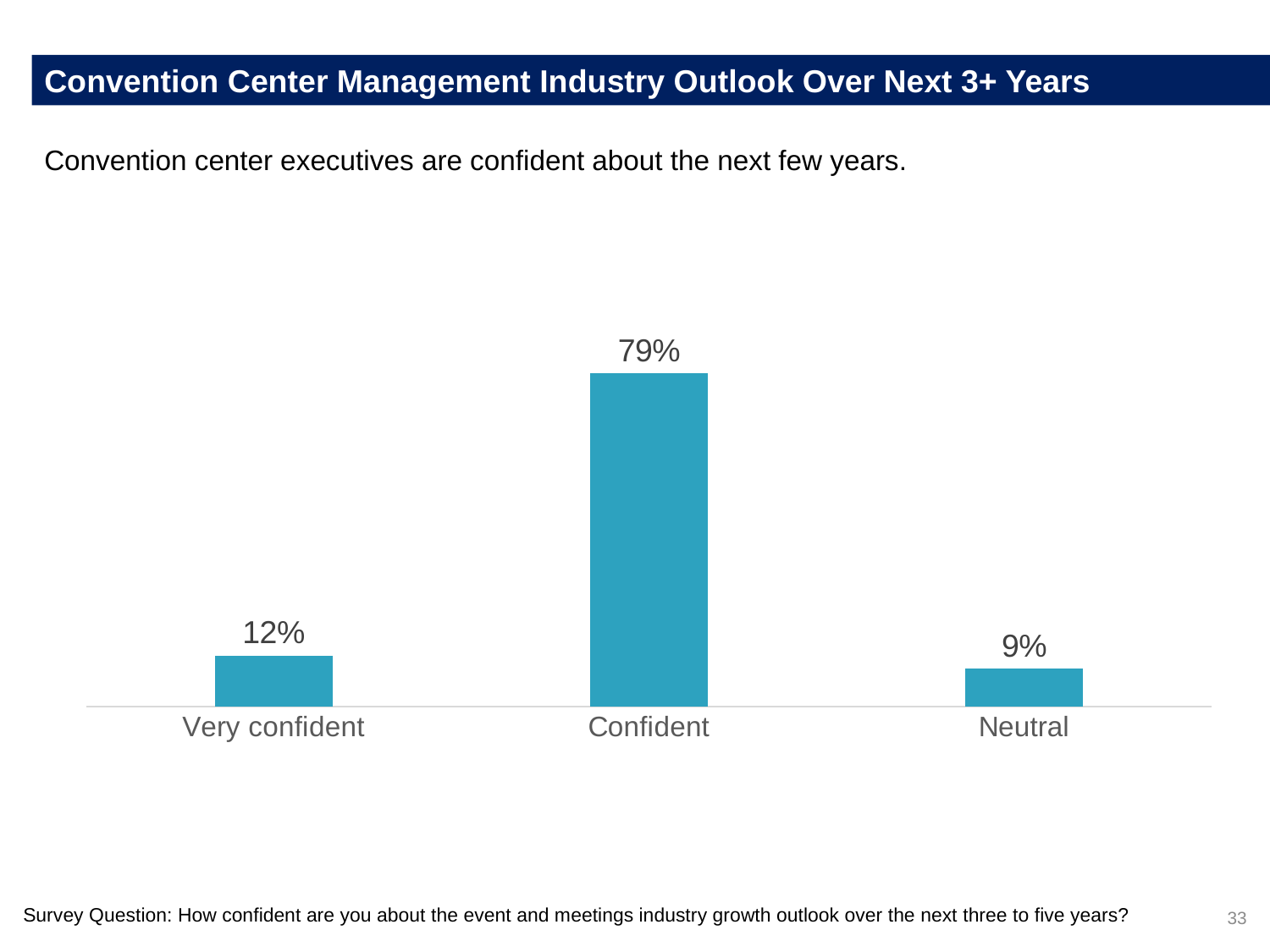
Which is larger, the value for Very confident or the value for Neutral? Very confident What is the title of the slide containing the chart? Convention Center Management Industry Outlook Over Next 3+ Years What percentage of respondents are Very confident? 12% Which category has the lowest value? Neutral What is the difference between the Very confident and Neutral values? 3% How many categories are shown in the chart? 3 What percentage of respondents are Confident? 79% What is the total of the three percentages shown in the chart? 100% What kind of chart is shown on the slide? Bar chart Which category has the highest value? Confident What percentage of respondents are Neutral? 9% What is the difference between the Confident and Very confident values? 67%